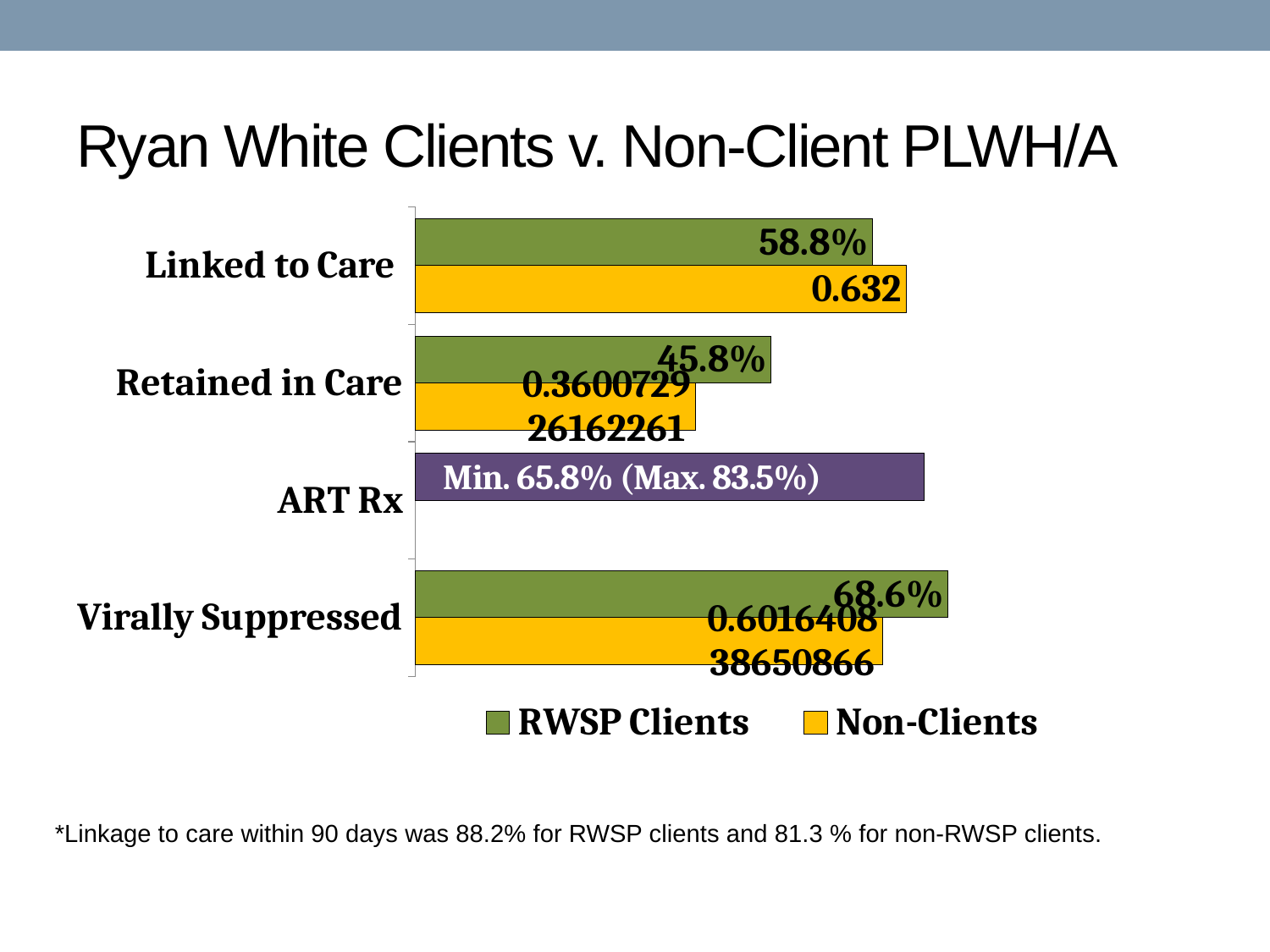
Which category has the lowest RWSP Clients value? Retained in Care How many series does the legend list? 2 What is the Non-Clients value for Linked to Care? 0.632 Which category has the highest RWSP Clients value? Virally Suppressed What is the difference between the RWSP Clients values for Virally Suppressed and Linked to Care? 9.8% For Retained in Care, which is larger: the RWSP Clients bar or the Non-Clients bar? RWSP Clients What label is printed on the ART Rx bar? Min. 65.8% (Max. 83.5%) What is the RWSP Clients value for Retained in Care? 45.8% For Linked to Care, which is larger: the RWSP Clients bar or the Non-Clients bar? Non-Clients What kind of chart is shown on the slide? Bar chart What is the RWSP Clients value for Virally Suppressed? 68.6% What is the RWSP Clients value for Linked to Care? 58.8%